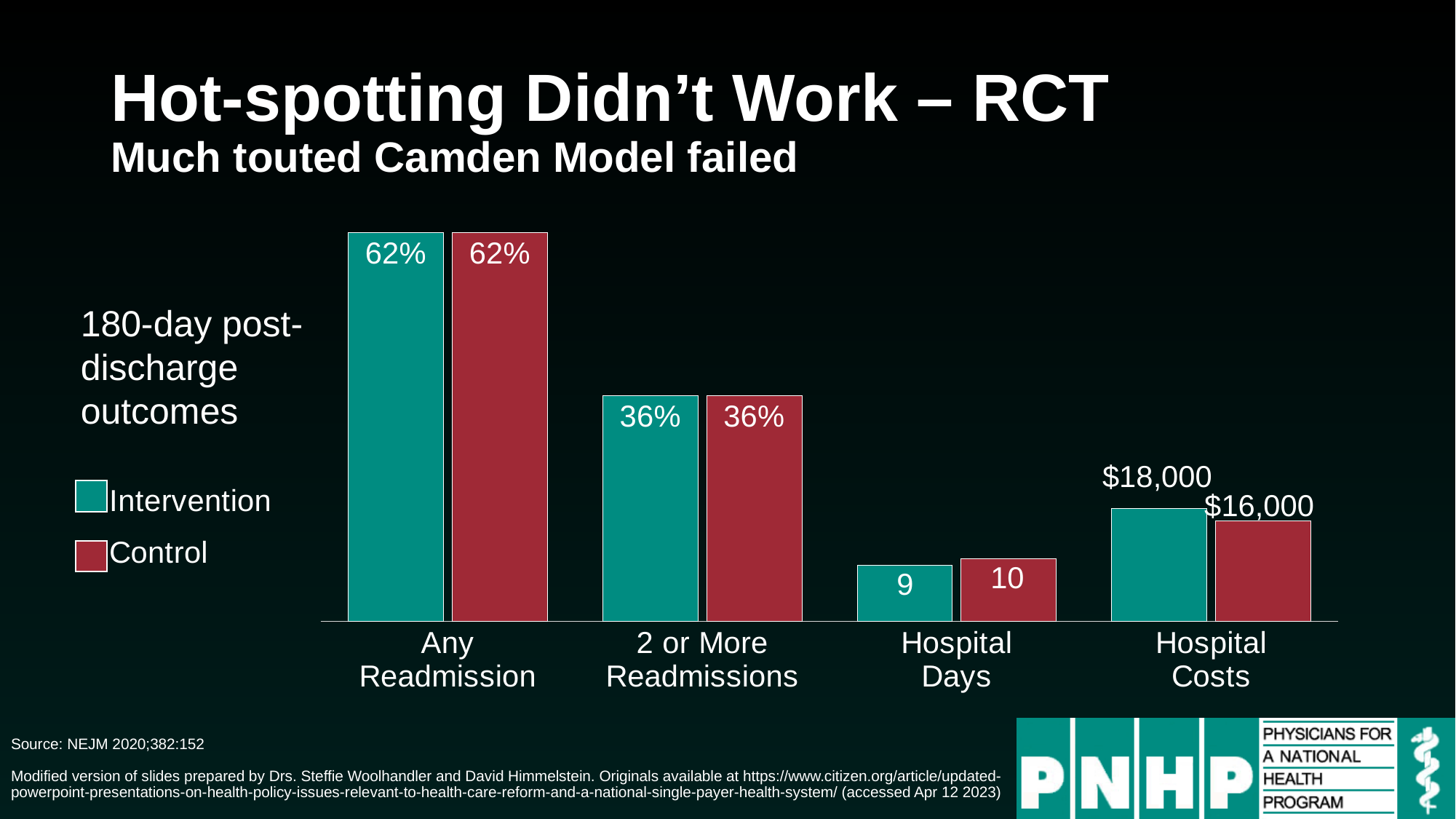
Which is larger for Hospital Days, the Intervention value or the Control value? Control What is the Intervention value for Hospital Days? 9 What kind of chart is shown on the slide? Bar chart What is the difference between the Intervention and Control values for Hospital Costs? $2,000 How many series does the legend list? 2 What is the Intervention value for Any Readmission? 62% What is the Control value for 2 or More Readmissions? 36% What is the difference between the Control and Intervention values for Hospital Days? 1 What is the Control value for Hospital Costs? $16,000 How many categories are shown on the x axis? 4 Which is larger for Hospital Costs, the Intervention value or the Control value? Intervention What is the Intervention value for Hospital Costs? $18,000